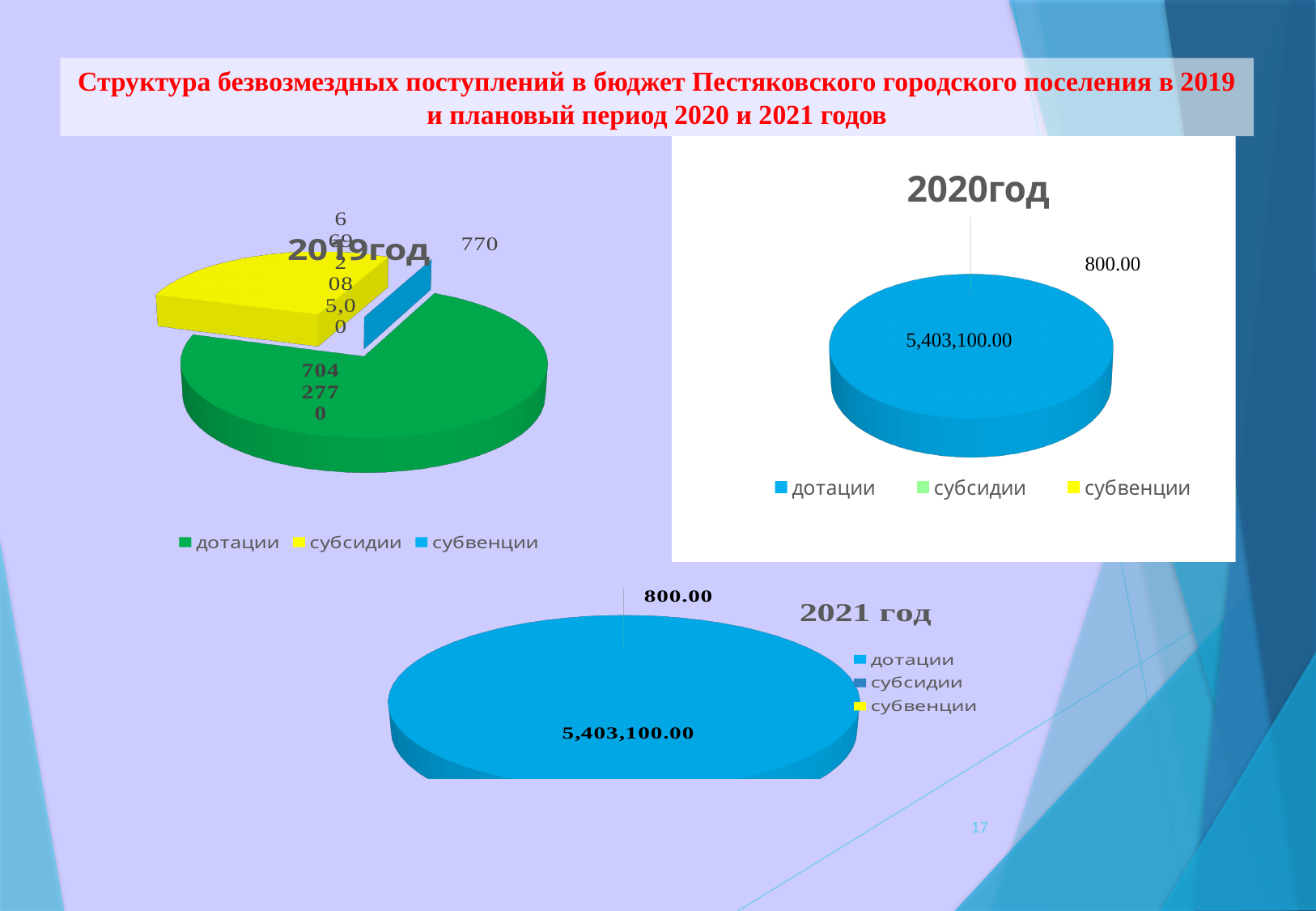
What is the title of the chart in the top-right of the slide? 2020год What kind of chart is the 2020год chart? pie chart How many series does the legend of the 2019год chart list? 3 In the 2020год chart, which category takes up almost the entire pie? дотации What kind of chart is the 2019год chart? pie chart In the 2019год chart, which category has the largest slice? дотации In the 2019год chart, what colour is the дотации slice? green In the 2019год chart, which category has the smallest slice? субвенции In the 2019год chart, which is larger, дотации or субсидии? дотации In the 2020год chart, what value is labeled for дотации? 5,403,100.00 How many series does the legend of the 2021 год chart list? 3 In the 2021 год chart, what value is labeled for дотации? 5,403,100.00